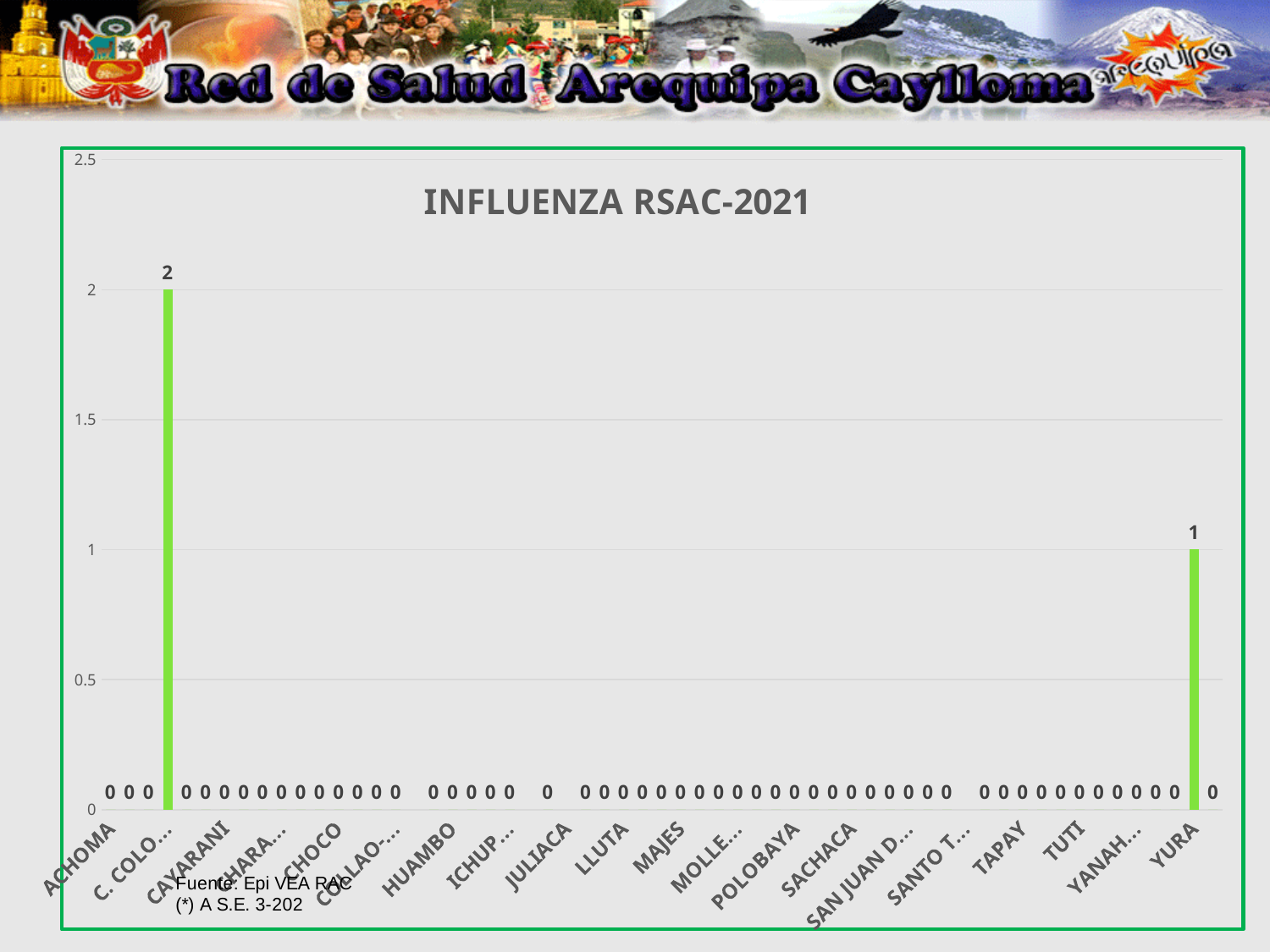
What is the value for TUTI? 0 What kind of chart is shown on the slide? bar chart What is the value for YURA? 1 What is the lowest value shown in the chart? 0 Which has a larger value, YURA or ACHOMA? YURA What is the title of the chart? INFLUENZA RSAC-2021 What is the highest value shown in the chart? 2 What is the value for ACHOMA? 0 Is the value for YURA greater or less than 1.5? less What is the difference between the highest value in the chart and the value for YURA? 1 How many categories have a value greater than 0? 2